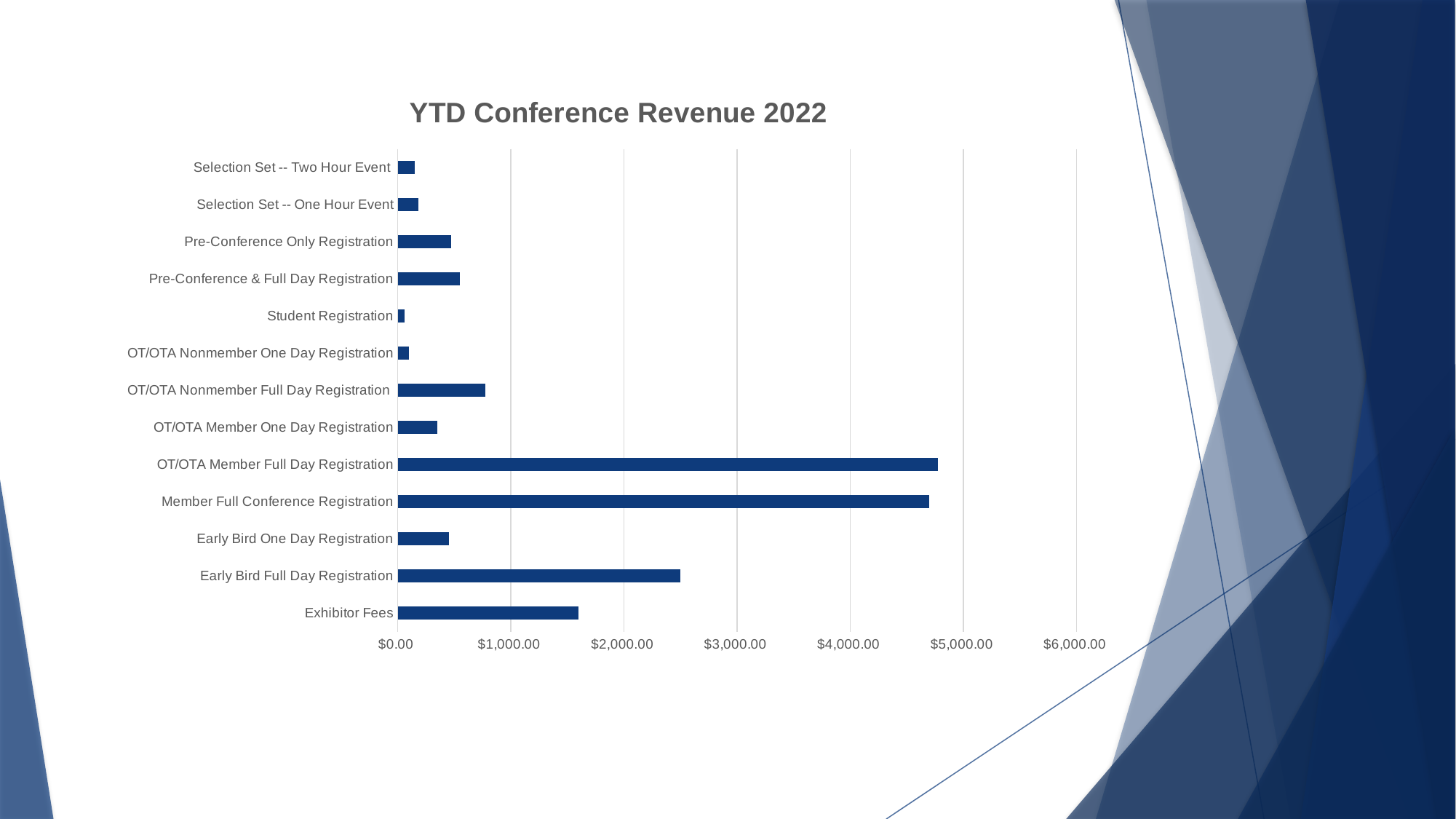
Is the value for Member Full Conference Registration greater or less than $4,000.00? greater Is the value for Early Bird One Day Registration greater or less than $1,000.00? less Which category has the lowest revenue? Student Registration What kind of chart is shown on the slide? bar chart Is the value for Exhibitor Fees greater or less than $1,000.00? greater What is the title of the chart? YTD Conference Revenue 2022 Which is larger, Early Bird Full Day Registration or Exhibitor Fees? Early Bird Full Day Registration How many categories are plotted in the chart? 13 What is the highest value shown on the horizontal axis? $6,000.00 Which is larger, Exhibitor Fees or OT/OTA Nonmember Full Day Registration? Exhibitor Fees